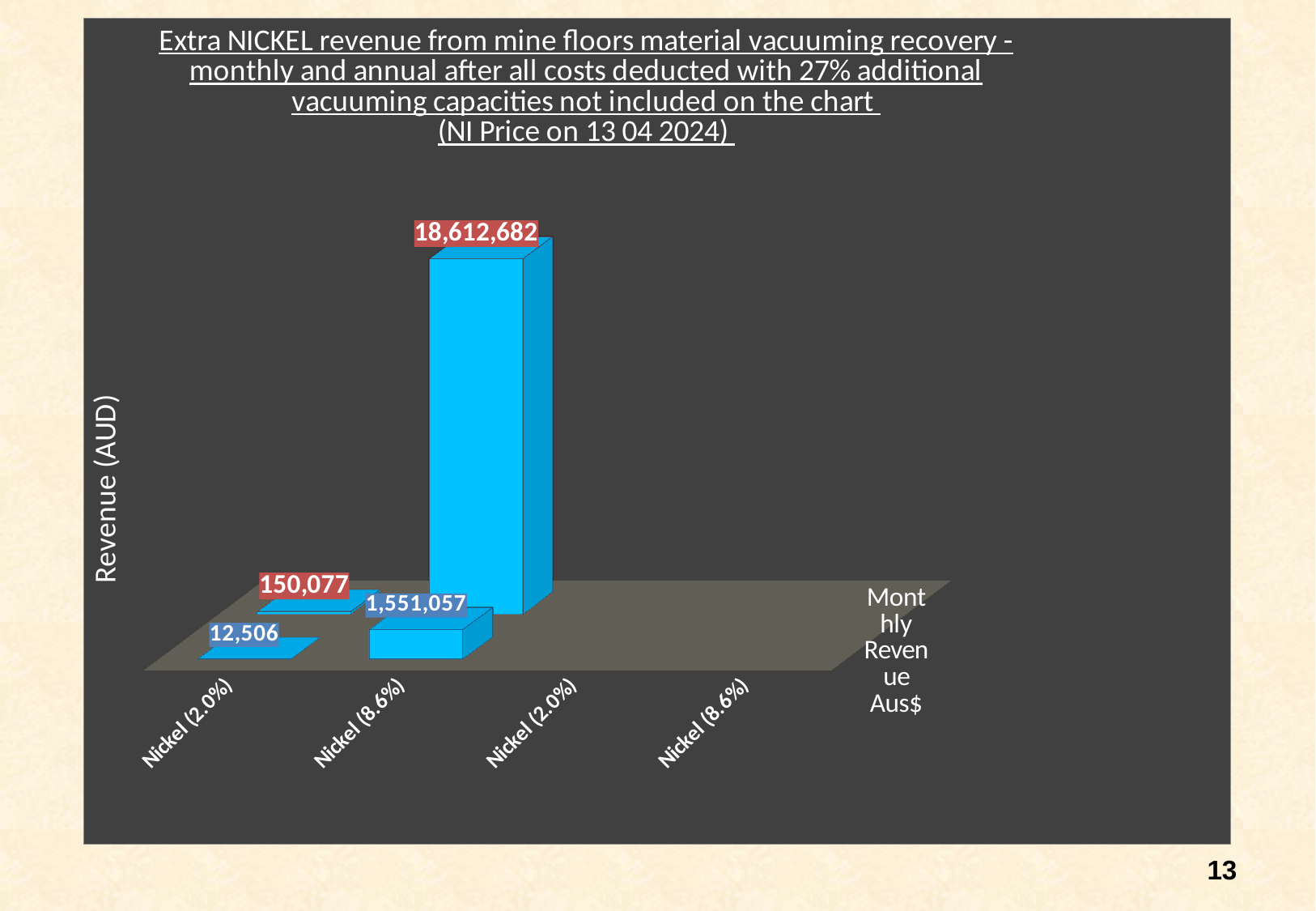
Which is larger, the bar labelled 1,551,057 or the bar labelled 150,077? 1,551,057 What is the highest value labelled on the chart? 18,612,682 How many data labels (bars) are shown on the chart? 4 What kind of chart is shown on the slide? Bar chart What is the title of the vertical axis? Revenue (AUD) Which is larger, the bar labelled 12,506 or the bar labelled 150,077? 150,077 What is the difference between the largest labelled value, 18,612,682, and the value 1,551,057? 17,061,625 What is the lowest value labelled on the chart? 12,506 Is the tallest bar's value greater or less than 10,000,000? greater What is the difference between the labelled values 150,077 and 12,506? 137,571 What nickel price date is given in the chart title? 13 04 2024